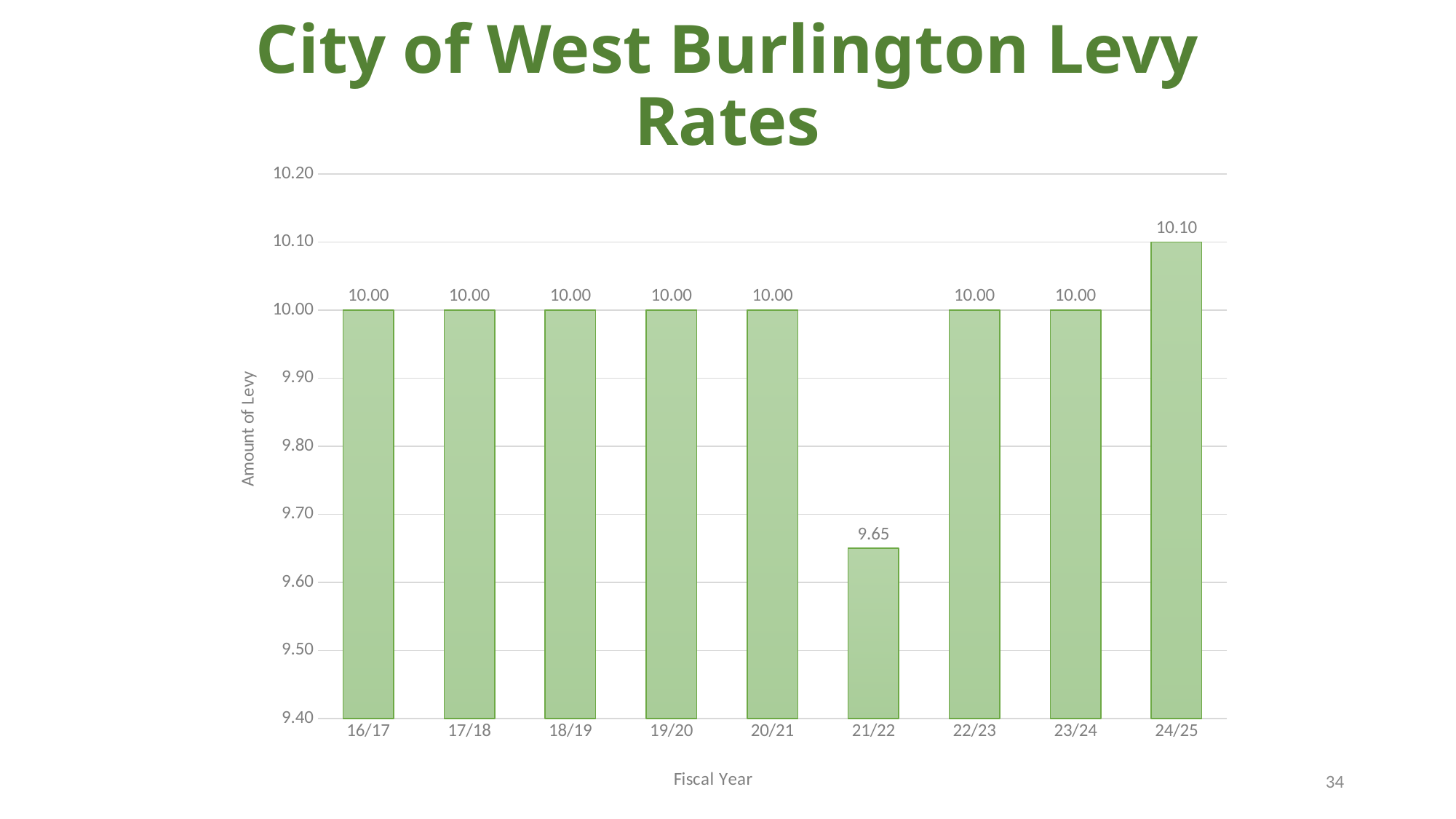
What is the levy rate for fiscal year 21/22? 9.65 What is the levy rate for fiscal year 24/25? 10.10 Which fiscal year has the highest levy rate? 24/25 Is the levy rate for 21/22 greater or less than 9.70? less Which fiscal year has the lowest levy rate? 21/22 What kind of chart is shown on the slide? bar chart What is the difference between the levy rate in 24/25 and the levy rate in 23/24? 0.10 What is the label of the vertical axis? Amount of Levy What is the difference between the levy rate in 24/25 and the levy rate in 21/22? 0.45 How many fiscal years are shown on the chart? 9 What is the levy rate for fiscal year 16/17? 10.00 Which is larger, the levy rate for 21/22 or the levy rate for 22/23? 22/23